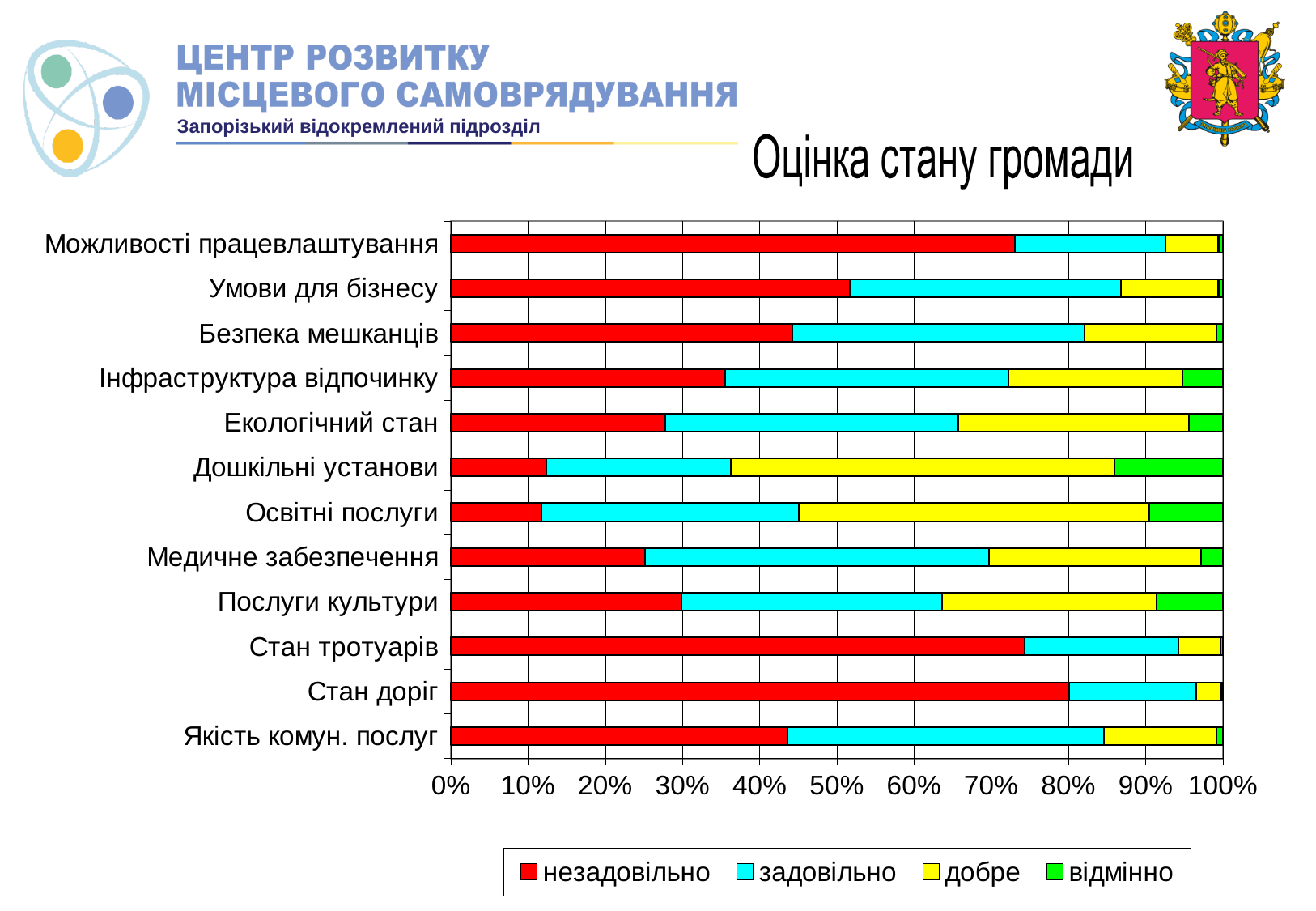
How many series does the legend list? 4 Is the 'незадовільно' share for Дошкільні установи greater or less than 20%? less Which colour represents the 'добре' series in the legend? yellow Which category has the largest 'незадовільно' share? Стан доріг What is the title of the chart? Оцінка стану громади Which has the larger 'незадовільно' share: Стан доріг or Якість комун. послуг? Стан доріг What kind of chart is shown on the slide? stacked bar chart Which category has the largest 'відмінно' share? Дошкільні установи How many categories are plotted on the chart? 12 Is the 'незадовільно' share for Умови для бізнесу greater or less than 50%? greater Is the 'незадовільно' share for Стан тротуарів greater or less than 70%? greater